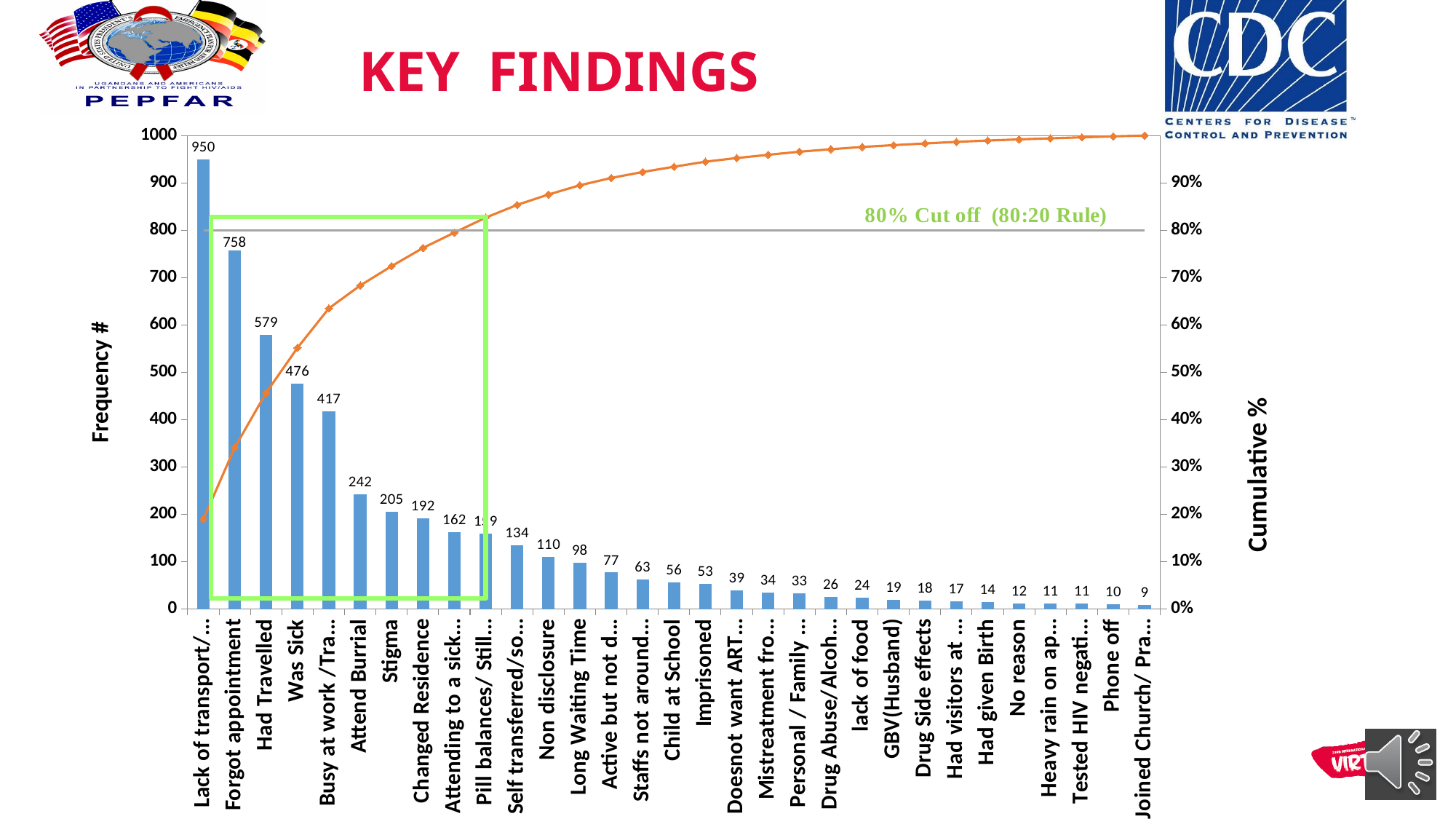
What is the frequency for Non disclosure? 110 Which has a higher frequency, Was Sick or Attend Burrial? Was Sick Is the cumulative % at Had Travelled greater or less than 50%? less What is the frequency for Phone off? 10 What is the frequency for Had Travelled? 579 What is the frequency for Stigma? 205 What is the difference in frequency between Forgot appointment and Had Travelled? 179 What is the highest frequency value shown on the chart? 950 What is the lowest frequency value shown on the chart? 9 What is the frequency for Forgot appointment? 758 What is the title of the right-hand vertical axis? Cumulative % Do the bar values rise or fall from left to right along the x axis? fall